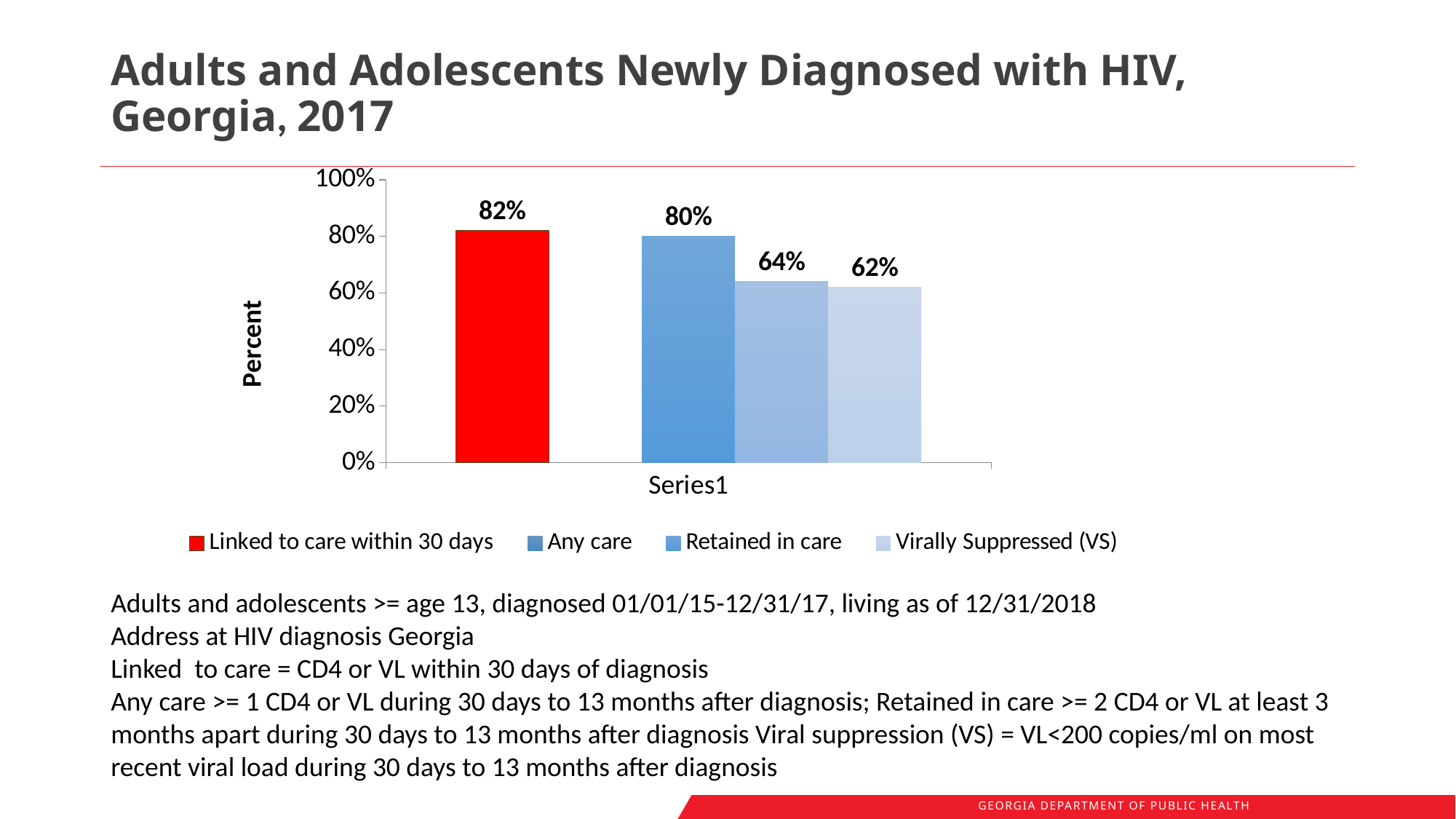
Which series has the lowest value? Virally Suppressed (VS) Which is larger, the value for Any care or the value for Retained in care? Any care What is the value for Linked to care within 30 days? 82% How many series does the legend list? 4 What is the value for Any care? 80% What is the value for Retained in care? 64% What is the difference between the Any care value and the Retained in care value? 16% What is the difference between the Linked to care within 30 days value and the Virally Suppressed (VS) value? 20% What kind of chart is shown on the slide? Bar chart What is the label on the vertical axis of the chart? Percent What is the value for Virally Suppressed (VS)? 62% Which series has the highest value? Linked to care within 30 days